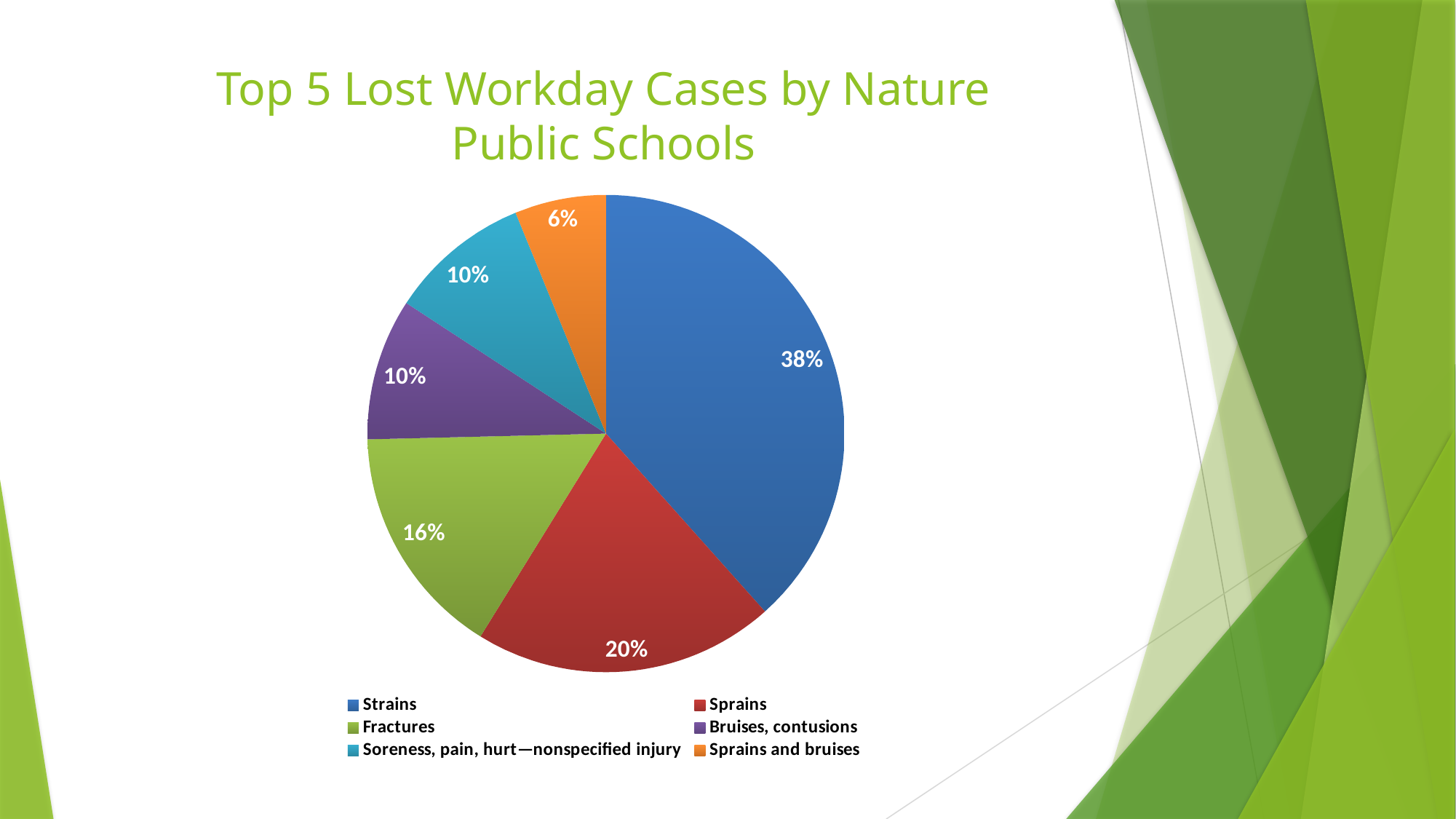
What percentage of lost workday cases is attributed to Sprains and bruises? 6% How many categories are shown in the pie chart? 6 What percentage of lost workday cases is attributed to Strains? 38% What is the title of the chart? Top 5 Lost Workday Cases by Nature Public Schools Which has a larger share, Fractures or Sprains? Sprains What percentage of lost workday cases is attributed to Sprains? 20% What percentage of lost workday cases is attributed to Fractures? 16% Which colour represents Bruises, contusions in the pie chart? Purple What is the difference in percentage points between Strains and Sprains? 18 Which category has the largest share of lost workday cases? Strains Which category has the smallest share of lost workday cases? Sprains and bruises What type of chart is shown on the slide? Pie chart